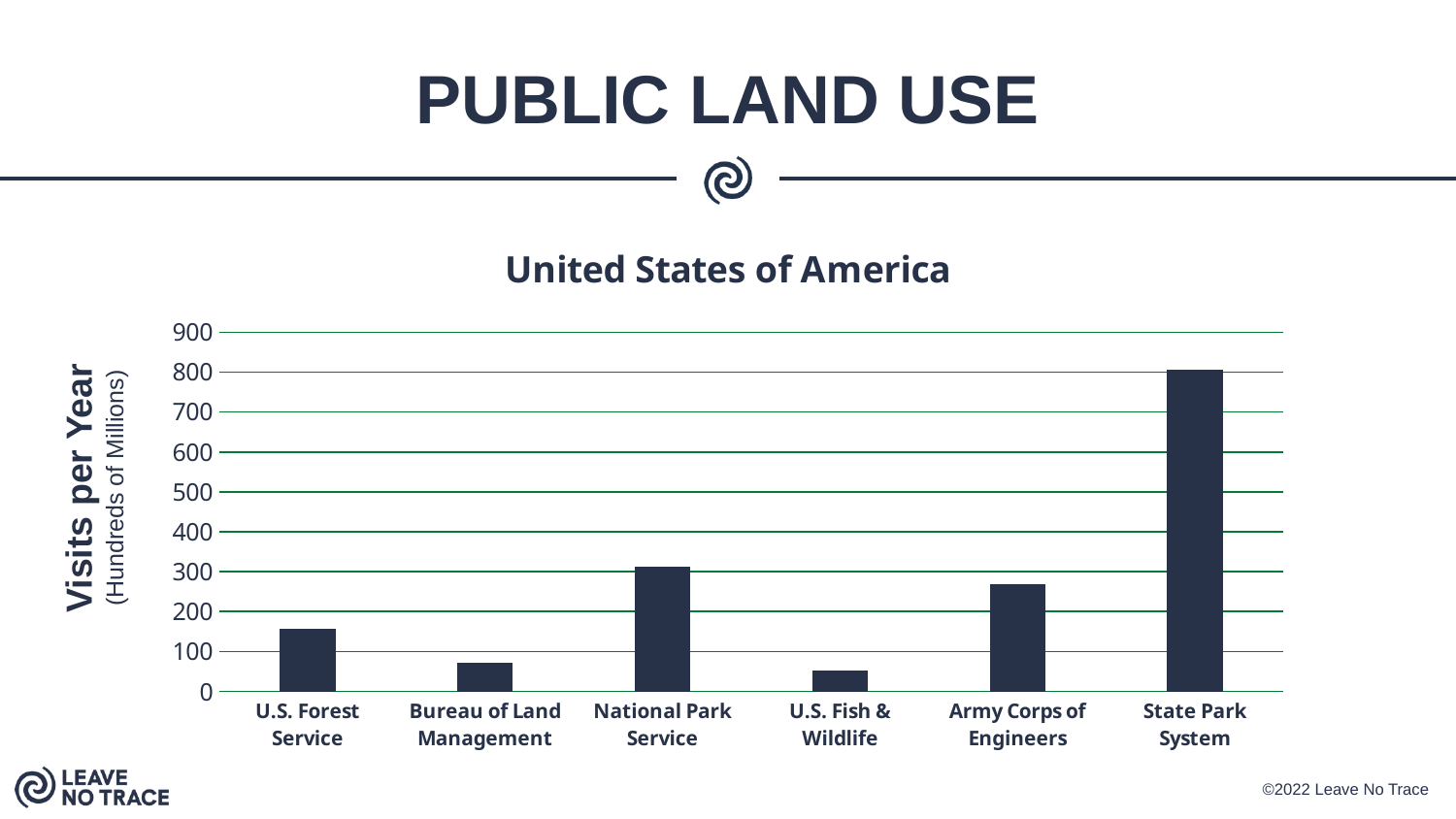
Which category has the lowest number of visits per year? U.S. Fish & Wildlife Which has more visits per year, Bureau of Land Management or U.S. Fish & Wildlife? Bureau of Land Management Is the value for Army Corps of Engineers greater or less than 300? less Is the value for State Park System greater or less than 700? greater What is the title of the chart? United States of America Is the value for U.S. Forest Service greater or less than 100? greater Which category has the highest number of visits per year? State Park System How many categories are shown on the x axis of the chart? 6 Which has more visits per year, National Park Service or Army Corps of Engineers? National Park Service What type of chart is shown on the slide? bar chart